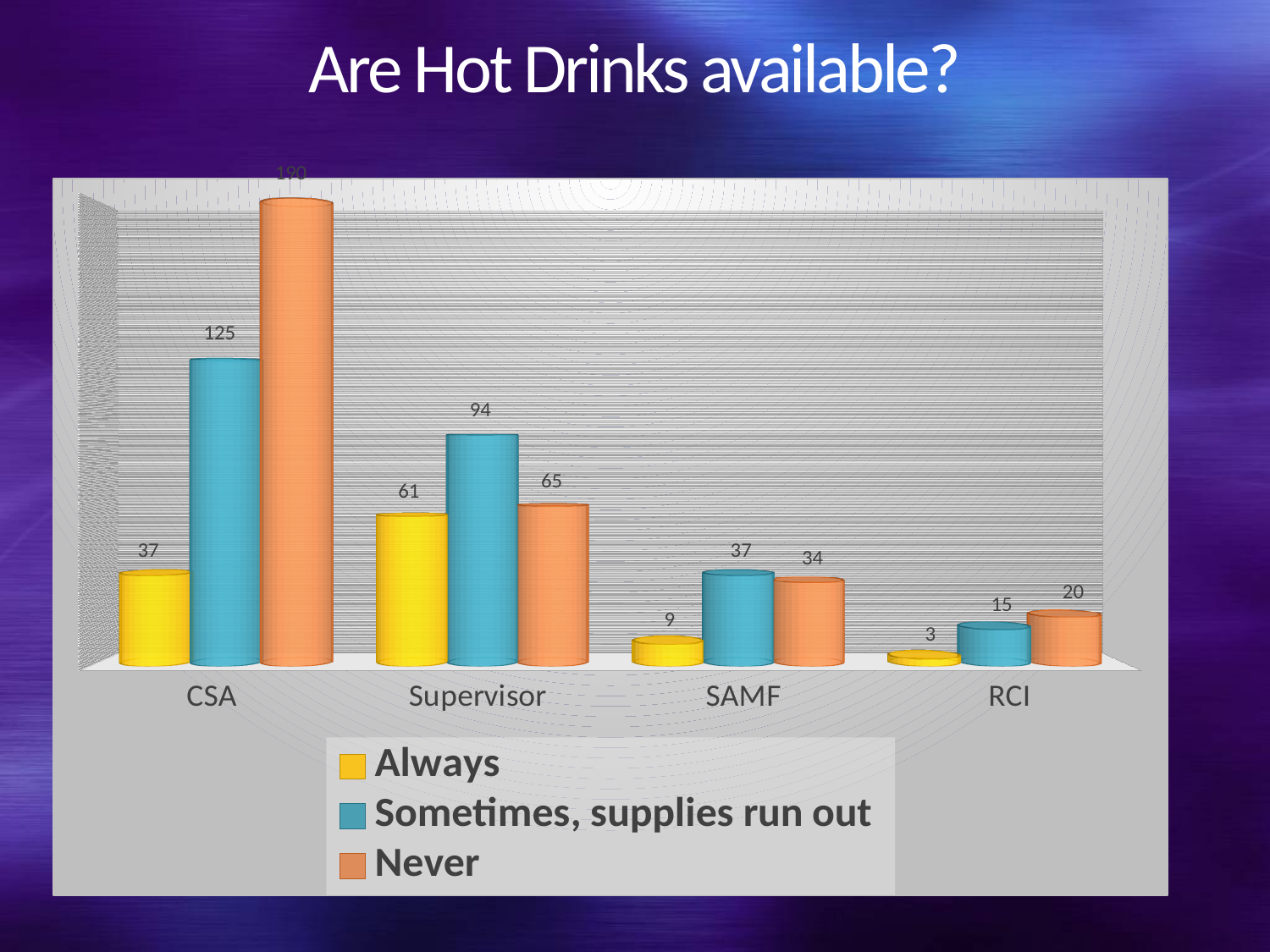
What is the value for Never in the SAMF category? 34 What is the value for Always in the CSA category? 37 Which category has the lowest value for Always? RCI Which is larger in the RCI category, the Sometimes, supplies run out value or the Never value? Never How many series does the legend list? 3 What is the difference between the Sometimes, supplies run out value and the Never value in the Supervisor category? 29 What kind of chart is shown on the slide? Bar chart How many categories are shown on the x axis? 4 What is the value for Always in the RCI category? 3 Which series has the highest value in the CSA category? Never What is the value for Sometimes, supplies run out in the Supervisor category? 94 What is the title of the chart? Are Hot Drinks available?